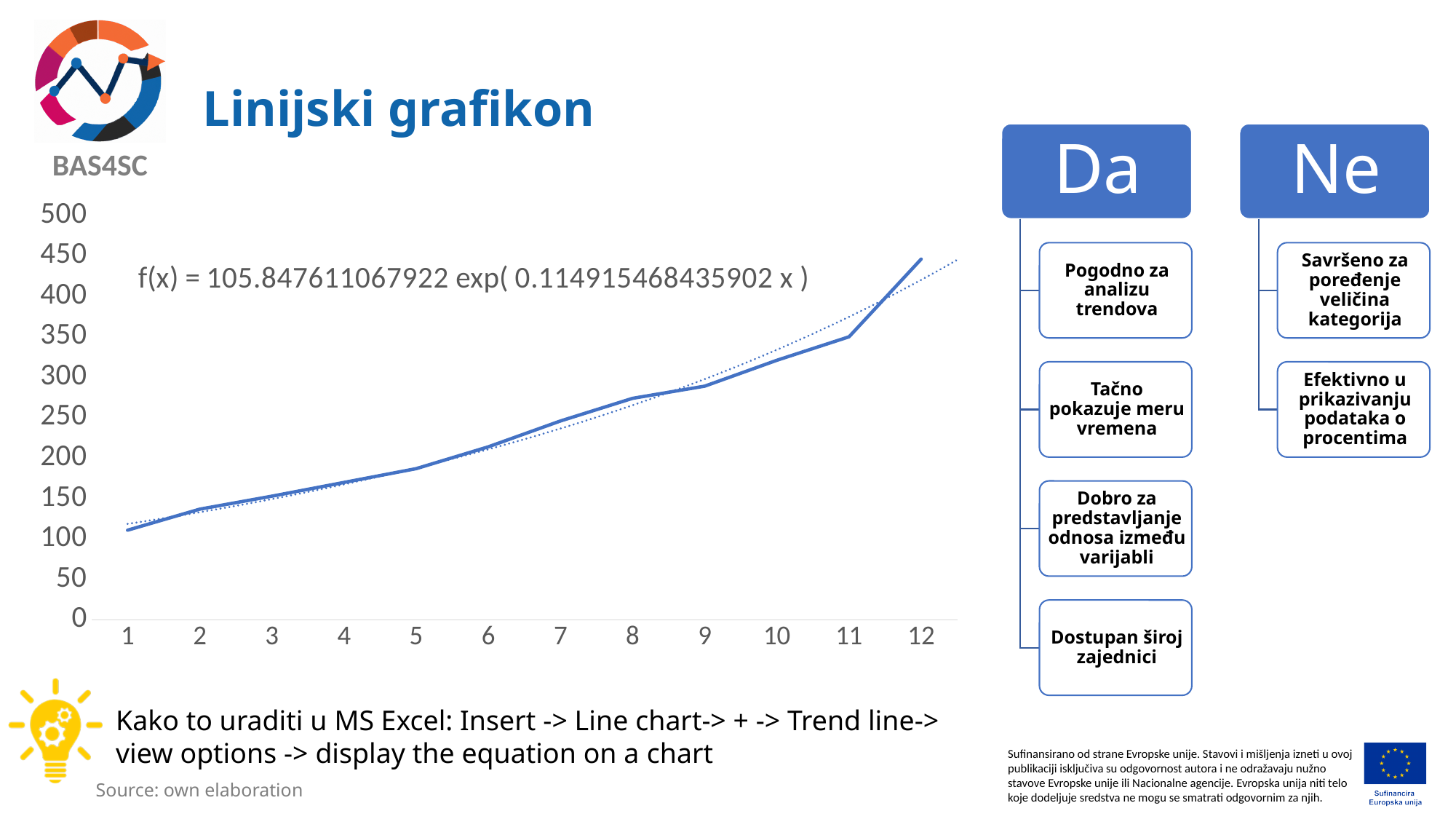
Do the values in the line chart rise or fall as x increases from 1 to 12? rise What kind of chart is shown on the slide? line chart At which x value does the line chart have its lowest value? 1 At which x value does the line chart reach its highest value? 12 Is the value at x = 12 greater or less than 400? greater How many data points are plotted along the x axis of the line chart? 12 What is the highest tick value shown on the y axis of the line chart? 500 Which has the larger value in the line chart, x = 12 or x = 1? 12 What is the trend line equation displayed on the chart? f(x) = 105.847611067922 exp( 0.114915468435902 x )